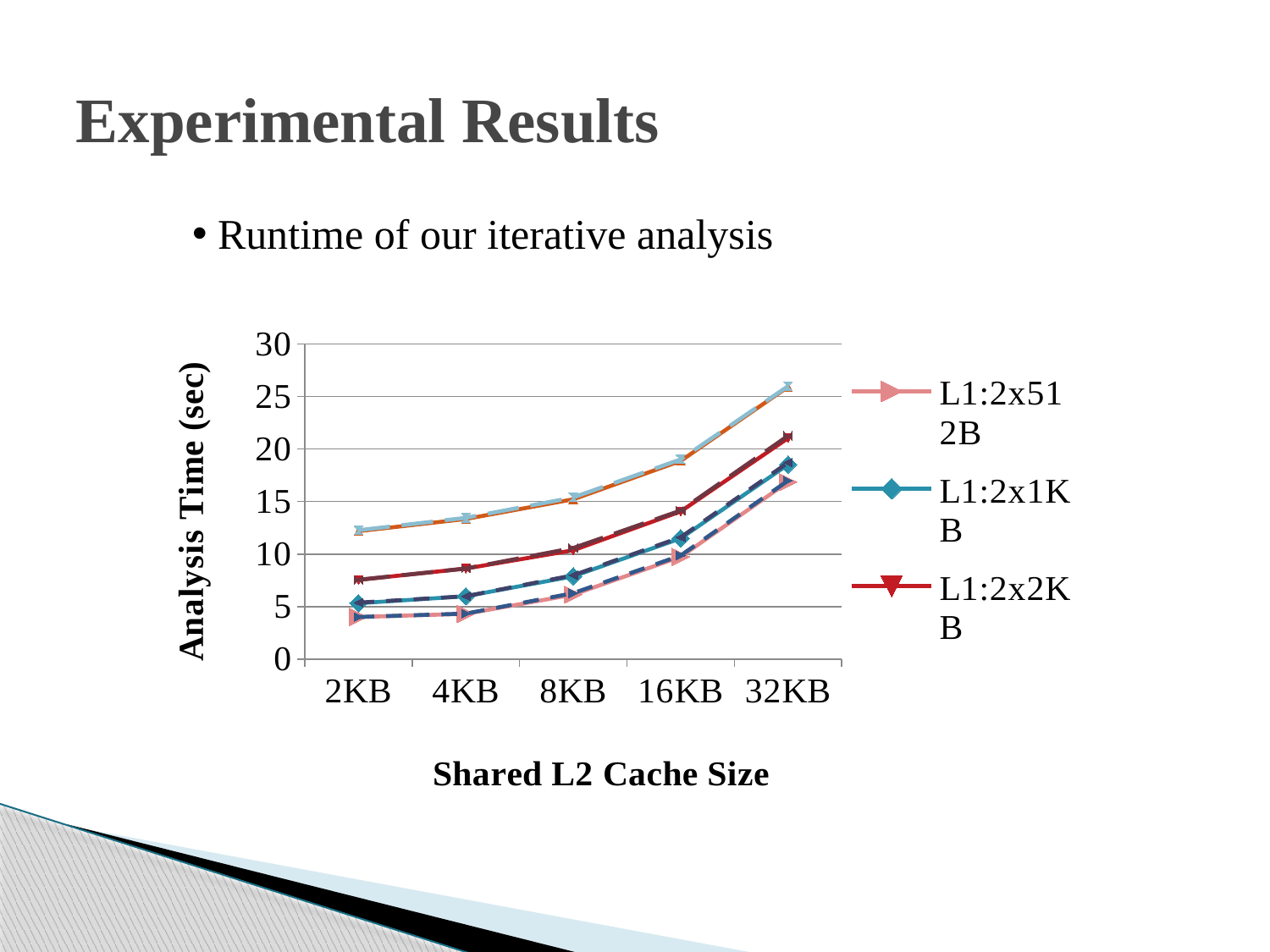
What kind of chart is shown on the slide? line chart At 32KB, which has the larger analysis time, L1:2x2KB or L1:2x512B? L1:2x2KB Is the analysis time for L1:2x512B at 2KB greater or less than 5? less Is the analysis time for L1:2x2KB at 2KB greater or less than 5? greater Does the analysis time rise or fall as the shared L2 cache size increases from 2KB to 32KB? rise Is the analysis time for L1:2x1KB at 32KB greater or less than 15? greater How many series does the legend list? 3 For the L1:2x2KB series, at which shared L2 cache size is the analysis time lowest? 2KB How many shared L2 cache sizes are shown on the x axis? 5 What is the title of the y axis? Analysis Time (sec) For the L1:2x1KB series, at which shared L2 cache size is the analysis time highest? 32KB